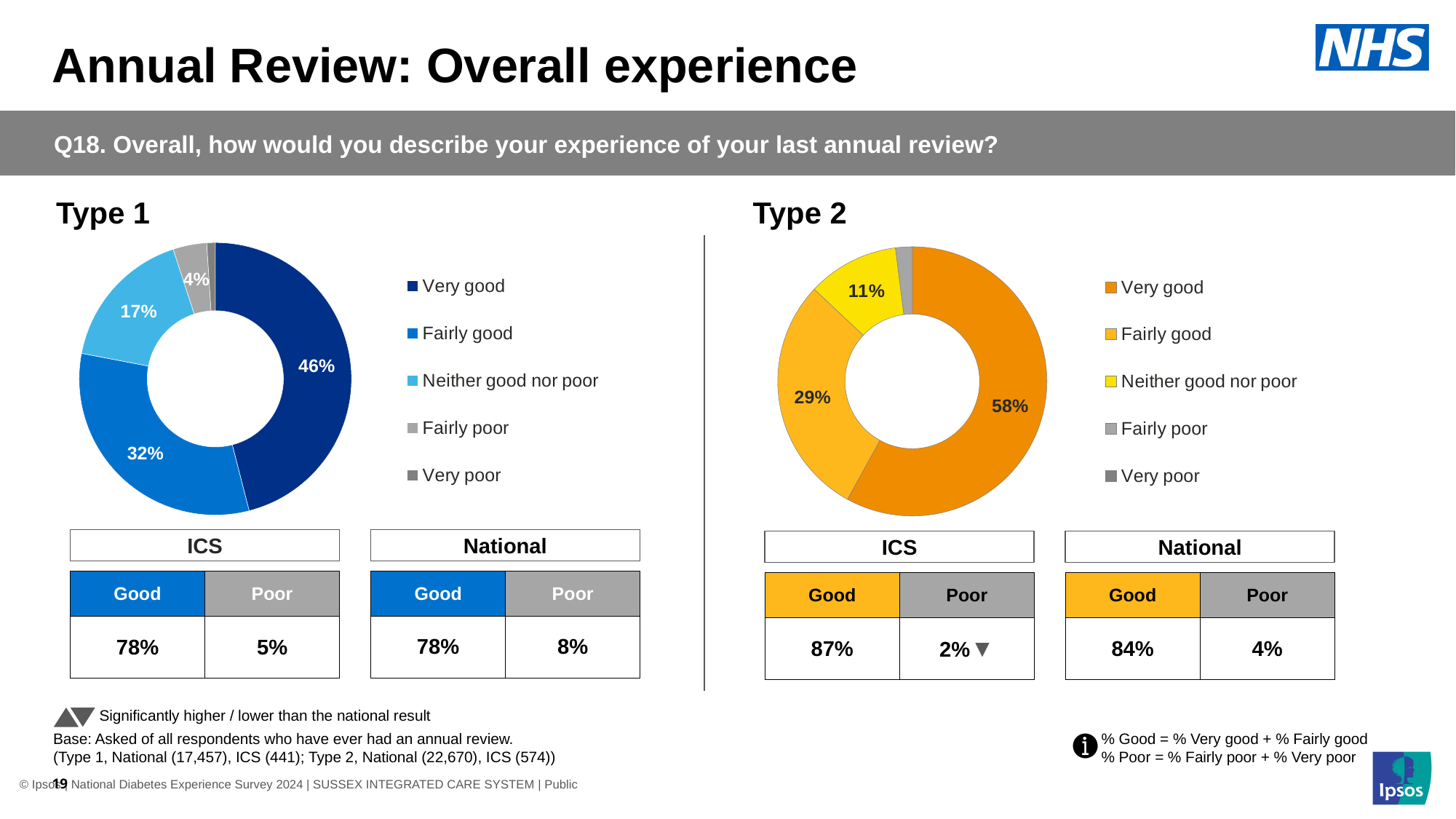
In the Type 2 chart, what percentage of respondents said their experience was Very good? 58% In the Type 2 chart, what percentage of respondents said their experience was Fairly good? 29% How many categories does the legend of the Type 2 chart list? 5 In the Type 2 chart, which response category has the largest share? Very good What kind of chart is used for the Type 1 results? Donut (pie) chart Which chart has the larger Very good share, Type 1 or Type 2? Type 2 In the Type 1 chart, what percentage of respondents said their experience was Very good? 46% In the Type 2 chart, what percentage of respondents said Neither good nor poor? 11% In the Type 1 chart, which response category has the largest share? Very good In the Type 1 chart, what is the difference between the Very good and Fairly good shares? 14% In the Type 1 chart, what percentage of respondents said Neither good nor poor? 17% In the Type 1 chart, what percentage of respondents said their experience was Fairly good? 32%